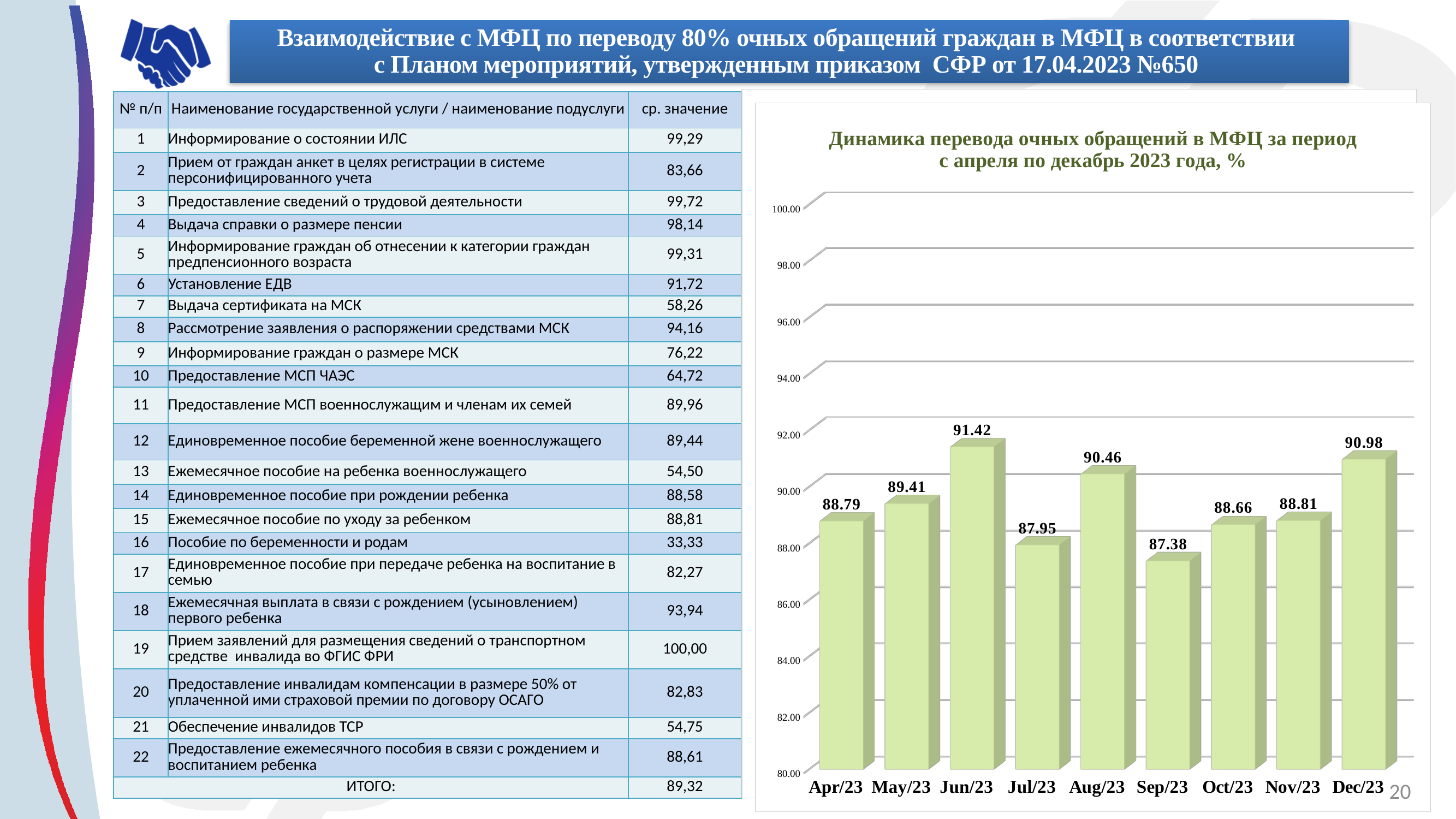
What is the value for Dec/23 on the chart? 90.98 Which month has the lowest value on the chart? Sep/23 Which month has the highest value on the chart? Jun/23 What is the difference between the values for Jun/23 and Sep/23? 4.04 What is the difference between the values for Dec/23 and Apr/23? 2.19 How many months are shown on the chart? 9 What is the value for Jun/23 on the chart? 91.42 Which is larger, the value for May/23 or the value for Aug/23? Aug/23 What kind of chart is shown on the slide? bar chart Does the value rise or fall from Jul/23 to Aug/23? rise What is the value for Sep/23 on the chart? 87.38 Is the value for Jul/23 greater or less than 90.00? less